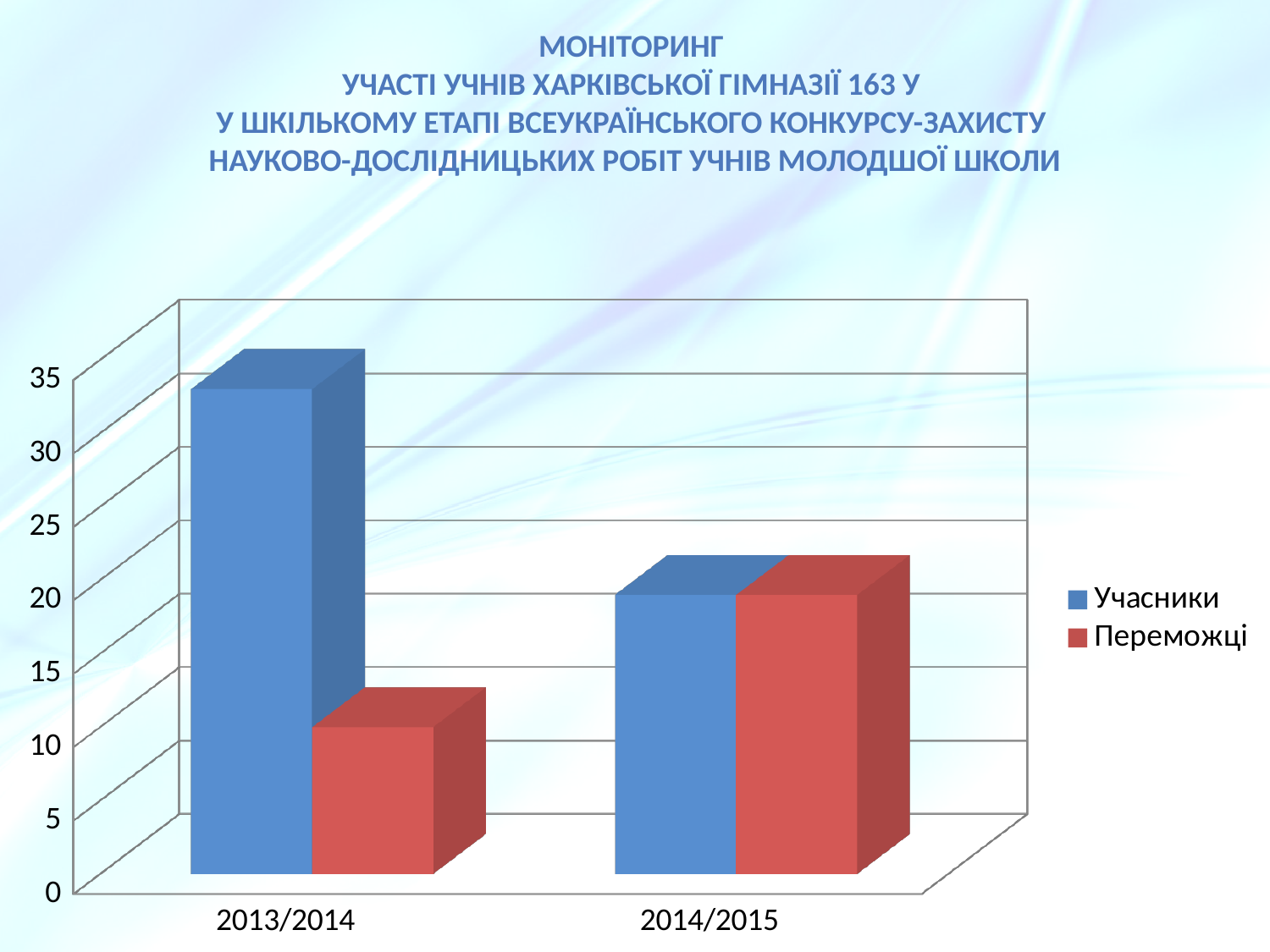
What are the two entries in the legend? Учасники, Переможці Is the value for Переможці in 2014/2015 greater or less than 15? greater How many categories are shown on the x axis? 2 Which series is shown in blue? Учасники Which is larger: Переможці in 2013/2014 or Переможці in 2014/2015? 2014/2015 How many series does the legend list? 2 In which year is the value for Переможці lowest? 2013/2014 What kind of chart is shown on the slide? bar chart In which year is the value for Учасники highest? 2013/2014 Is the value for Учасники in 2014/2015 greater or less than 25? less Is the value for Переможці in 2013/2014 greater or less than 15? less